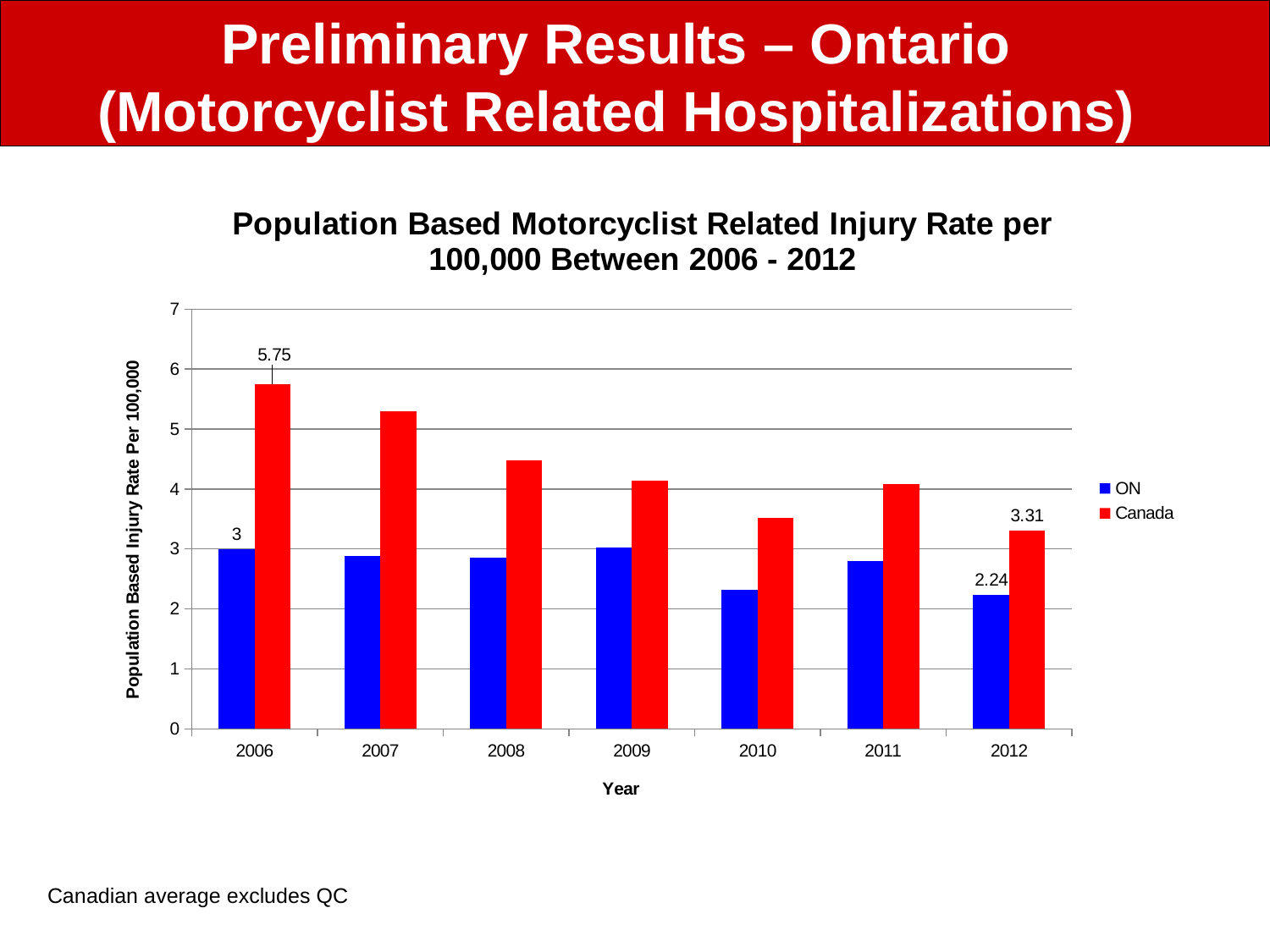
How many years are shown on the x axis? 7 What is the Canada injury rate per 100,000 in 2006? 5.75 Is the Canada rate for 2007 greater or less than 5? greater How many series does the legend list? 2 By how much does the Canada rate exceed the ON rate in 2006? 2.75 In which year is the Canada injury rate highest? 2006 What is the Canada injury rate per 100,000 in 2012? 3.31 Is the ON rate for 2010 greater or less than 3? less What is the ON injury rate per 100,000 in 2006? 3 What is the ON injury rate per 100,000 in 2012? 2.24 By how much did the Canada rate fall from 2006 to 2012? 2.44 In 2009, which is larger, the ON rate or the Canada rate? Canada